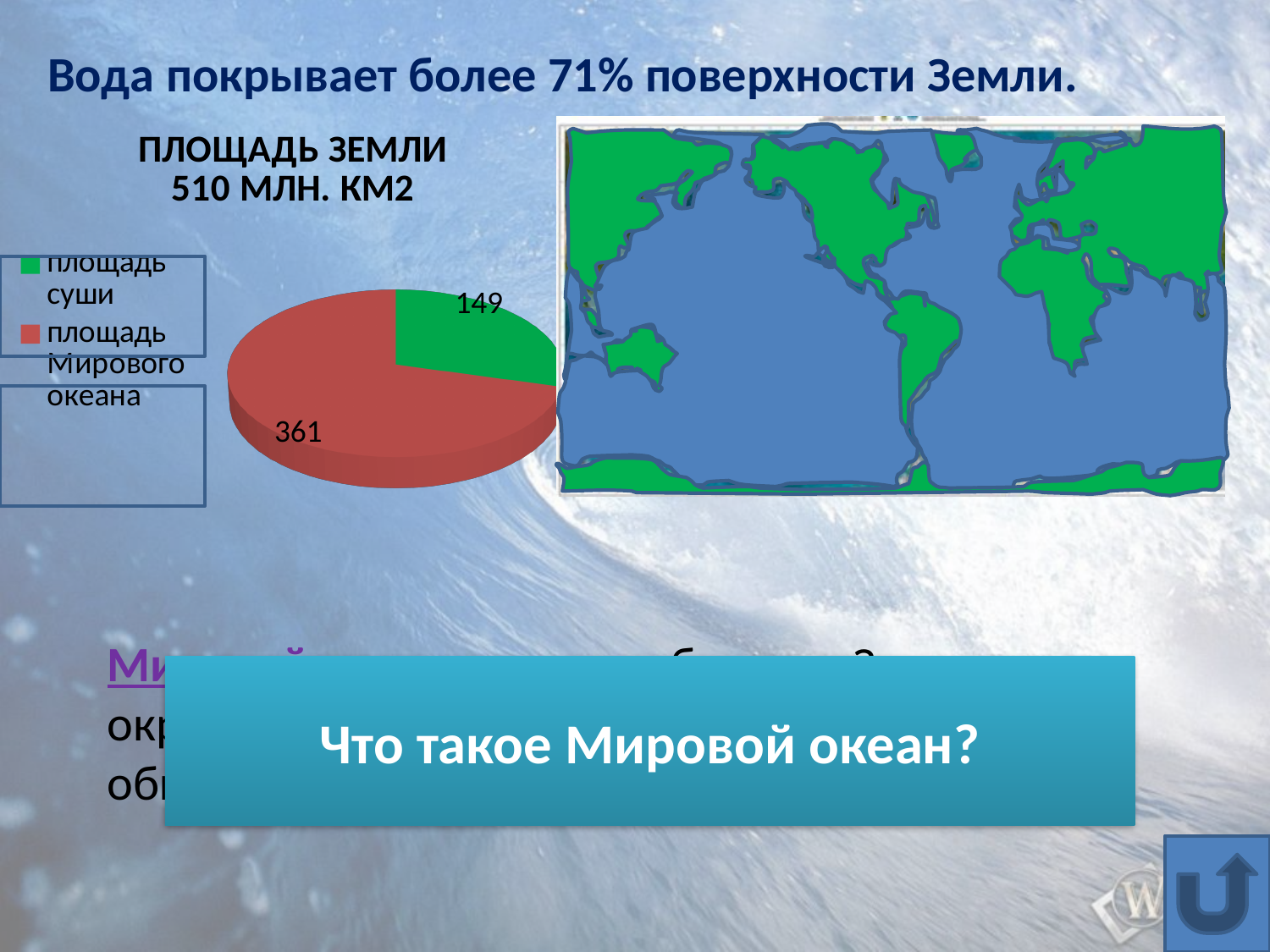
How many slices does the pie chart have? 2 What colour is the 'площадь Мирового океана' slice in the pie chart? red Which slice of the pie chart is the smallest? площадь суши What is the difference between the 'площадь Мирового океана' and 'площадь суши' values in the pie chart? 212 What is the total of the two values shown in the pie chart? 510 Which slice of the pie chart is the largest? площадь Мирового океана What is the title of the pie chart? ПЛОЩАДЬ ЗЕМЛИ 510 МЛН. КМ2 Which is larger in the pie chart: 'площадь суши' or 'площадь Мирового океана'? площадь Мирового океана What is the value of the 'площадь Мирового океана' slice in the pie chart? 361 How many entries does the legend of the pie chart list? 2 What type of chart is shown on the slide? pie chart What is the value of the 'площадь суши' slice in the pie chart? 149